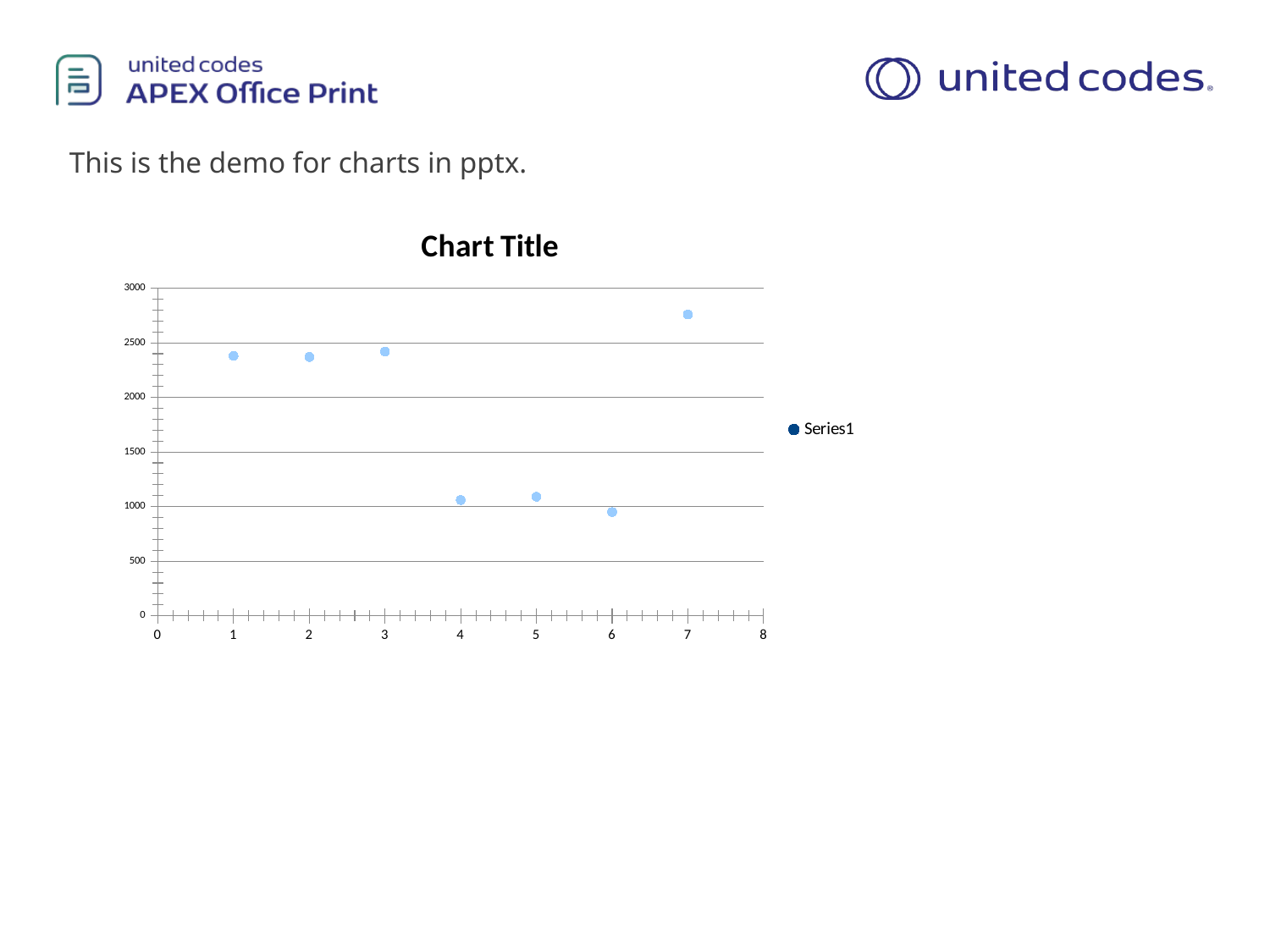
Is the value at x = 6 greater or less than 1000? less How many data points are plotted in the chart? 7 What is the name of the series shown in the legend? Series1 Is the value at x = 1 greater or less than 2500? less Which has the larger value, the point at x = 3 or the point at x = 4? x = 3 What kind of chart is shown on the slide? scatter chart What is the title of the chart? Chart Title Is the value at x = 4 greater or less than 1000? greater How many series does the chart legend list? 1 At which x value is the plotted point highest? 7 At which x value is the plotted point lowest? 6